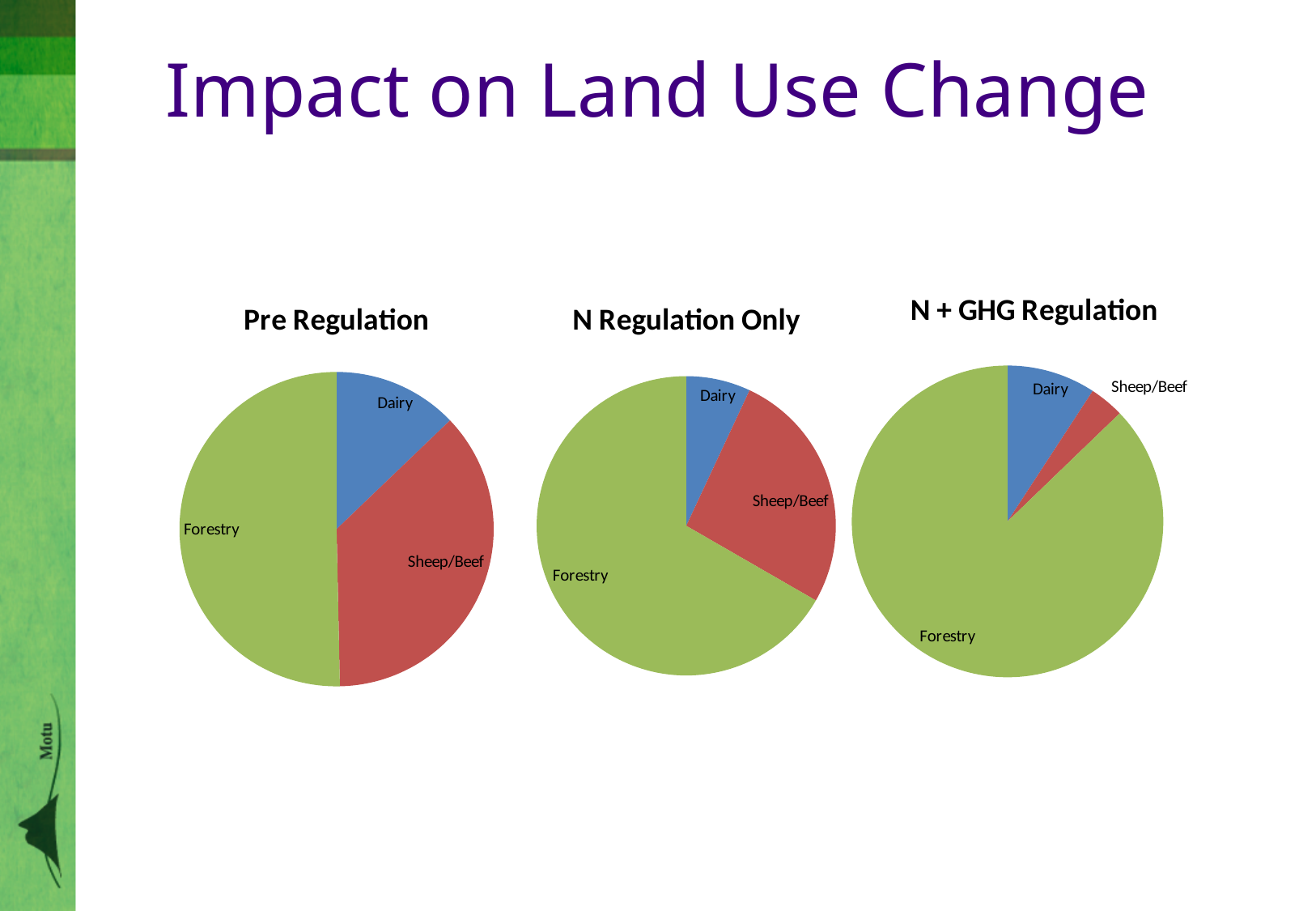
In the "N Regulation Only" chart, which category has the largest slice? Forestry What is the title of the rightmost pie chart? N + GHG Regulation How many slices does the "N Regulation Only" pie chart have? 3 In the "N + GHG Regulation" chart, which slice is larger, Dairy or Sheep/Beef? Dairy In the "N Regulation Only" chart, which category has the smallest slice? Dairy In the "Pre Regulation" chart, which category has the largest slice? Forestry How many pie charts are shown on the slide? 3 In the "Pre Regulation" chart, which slice is larger, Sheep/Beef or Dairy? Sheep/Beef In the "N + GHG Regulation" chart, which category has the largest slice? Forestry In the "N + GHG Regulation" chart, which category has the smallest slice? Sheep/Beef In the "Pre Regulation" chart, which category has the smallest slice? Dairy What kind of chart is the "Pre Regulation" chart? Pie chart